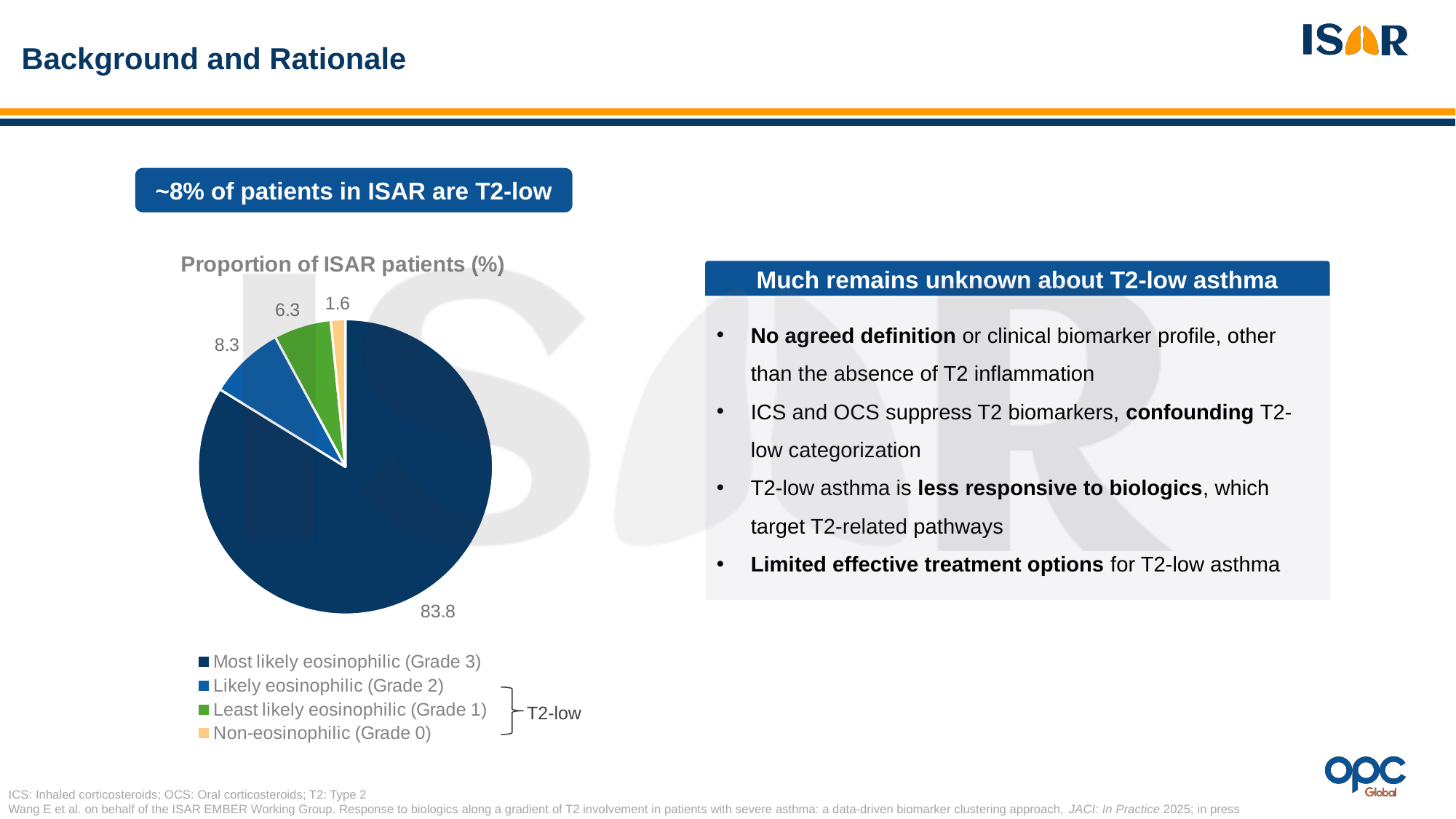
Which is larger, the value for Least likely eosinophilic (Grade 1) or Non-eosinophilic (Grade 0)? Least likely eosinophilic (Grade 1) Which legend entries are bracketed together as T2-low? Least likely eosinophilic (Grade 1) and Non-eosinophilic (Grade 0) Which category has the smallest slice of the pie? Non-eosinophilic (Grade 0) Which category has the largest slice of the pie? Most likely eosinophilic (Grade 3) What is the value for Likely eosinophilic (Grade 2)? 8.3 What is the value for Non-eosinophilic (Grade 0)? 1.6 What type of chart is shown on the slide? Pie chart What is the value for Most likely eosinophilic (Grade 3)? 83.8 What is the value for Least likely eosinophilic (Grade 1)? 6.3 How many categories does the legend list? 4 What is the difference between the values for Likely eosinophilic (Grade 2) and Least likely eosinophilic (Grade 1)? 2.0 What is the title of the chart? Proportion of ISAR patients (%)